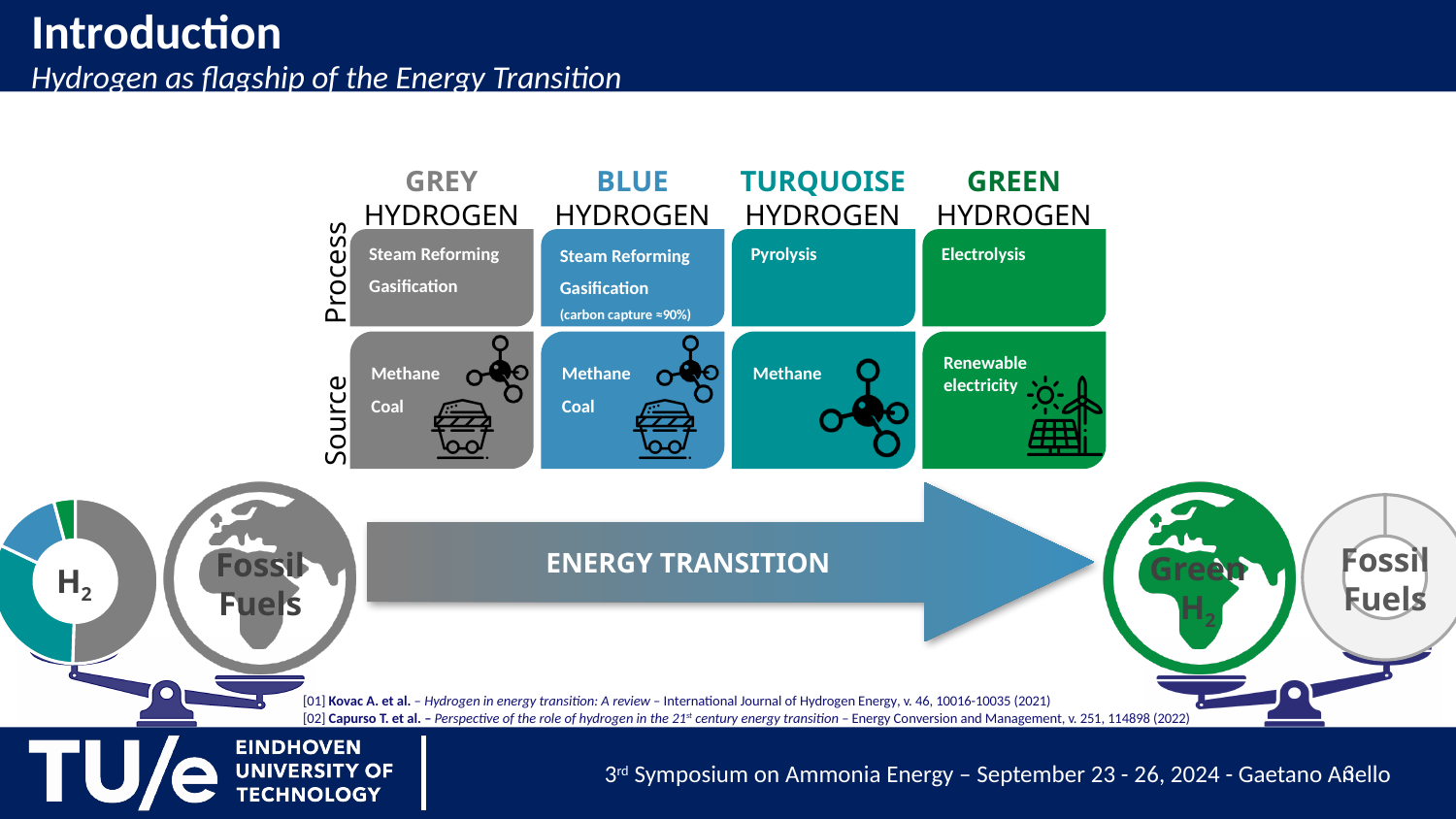
In the H2 chart on the left of the slide, which colour slice is the largest? grey What kind of chart is the one labelled H2 on the left of the slide? doughnut chart In the H2 chart on the left of the slide, which colour slice is the smallest? green In the H2 chart on the left of the slide, which slice is larger, the teal one or the blue one? teal What label is written in the centre of the chart on the left of the slide? H2 What label is written in the centre of the chart on the far right of the slide? Fossil Fuels How many slices does the H2 chart on the left of the slide have? 4